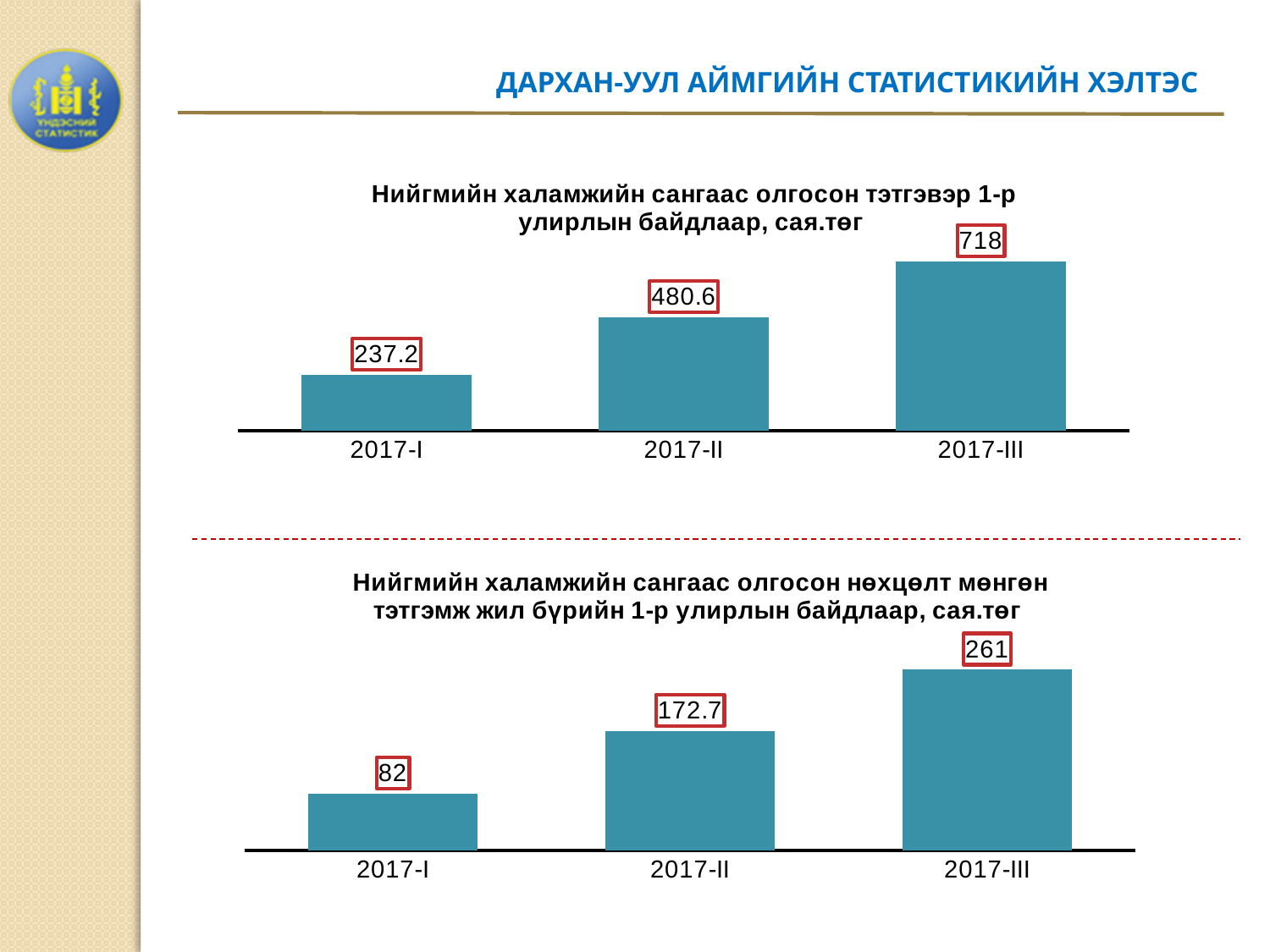
How many categories are shown in the bottom chart? 3 In the bottom chart, what is the value for 2017-I? 82 In the bottom chart, which category has the highest value? 2017-III In the bottom chart, what is the value for 2017-II? 172.7 In the bottom chart, what is the difference between the values for 2017-III and 2017-II? 88.3 In the top chart, what is the difference between the values for 2017-III and 2017-I? 480.8 In the bottom chart, which is larger, the value for 2017-I or the value for 2017-II? 2017-II What kind of chart is the top chart? bar chart In the top chart, do the values rise or fall from 2017-I to 2017-III? rise In the top chart, what is the value for 2017-III? 718 In the top chart, which category has the lowest value? 2017-I In the top chart, what is the value for 2017-II? 480.6